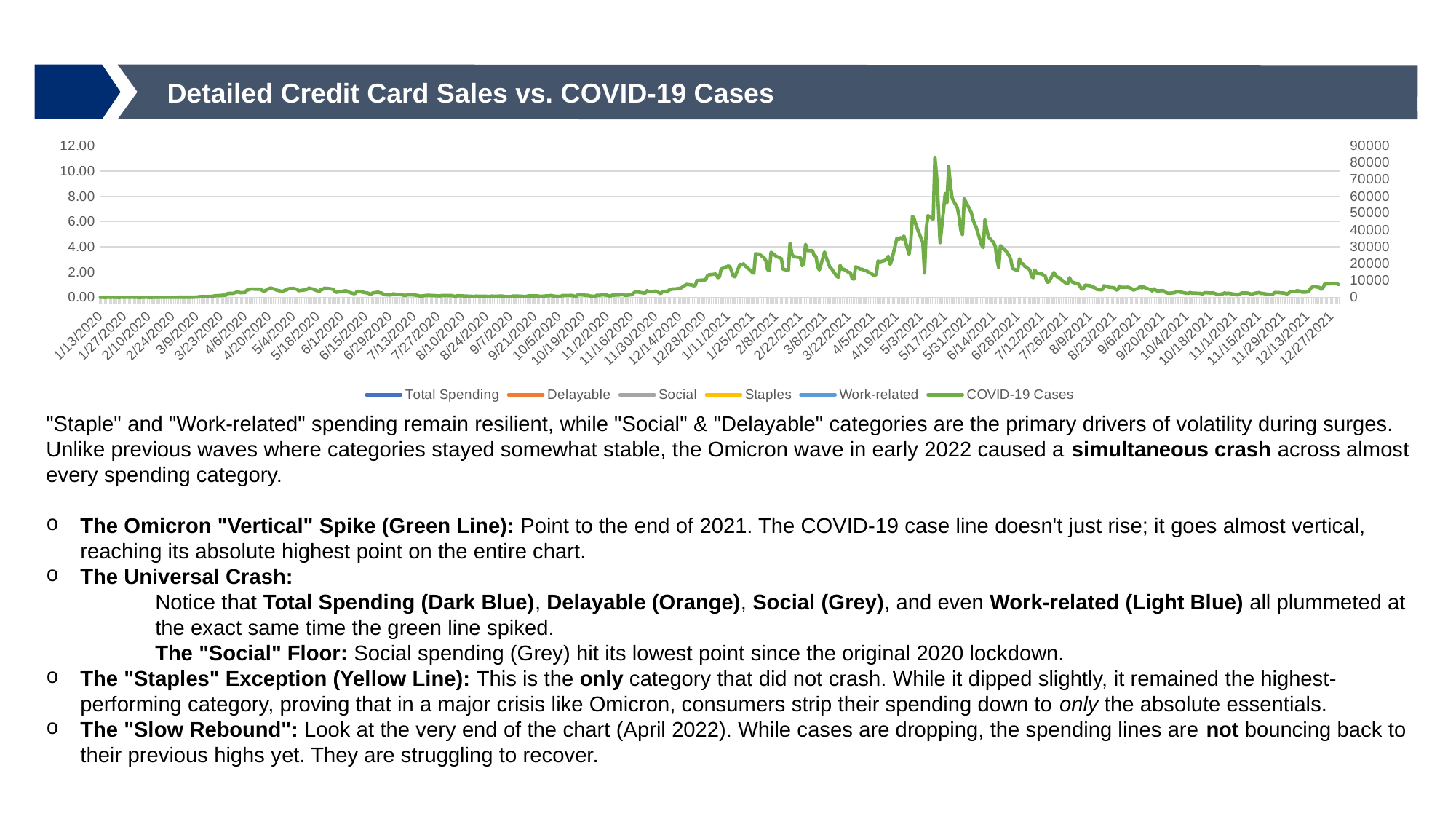
Is the COVID-19 Cases value higher at 2/22/2021 or at 7/13/2020? 2/22/2021 Is the COVID-19 Cases value higher at 5/17/2021 or at 8/9/2021? 5/17/2021 Which series in the legend is drawn in green? COVID-19 Cases On the right-hand axis, is the COVID-19 Cases value at 9/20/2021 greater or less than 30000? less Does the COVID-19 Cases line rise or fall between 5/17/2021 and 9/6/2021? fall What is the title of the slide's chart section? Detailed Credit Card Sales vs. COVID-19 Cases How many series does the chart legend list? 6 What kind of chart is shown on the slide? line chart Does the COVID-19 Cases line rise or fall between 12/14/2020 and 5/3/2021? rise On the right-hand axis, is the COVID-19 Cases value at 1/13/2020 greater or less than 10000? less On the right-hand axis, is the peak value of the COVID-19 Cases line greater or less than 60000? greater Around which month does the COVID-19 Cases line reach its highest point? May 2021